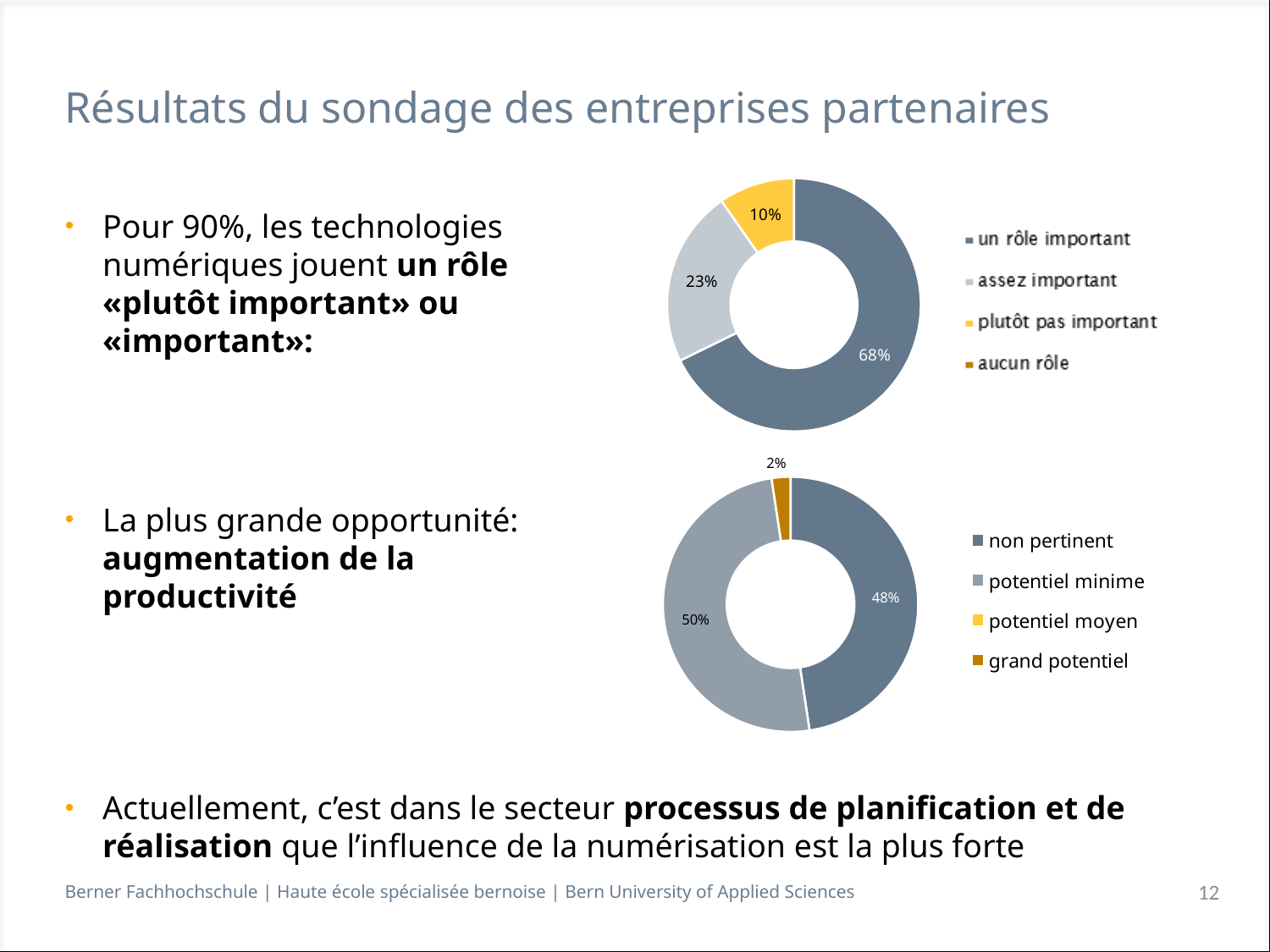
In the top doughnut chart, which category has the largest share? un rôle important How many entries does the legend of the bottom doughnut chart list? 4 What type of chart is the top chart on the slide? Doughnut chart In the bottom doughnut chart, what percentage is shown for "potentiel minime"? 50% In the top doughnut chart, what percentage is shown for "plutôt pas important"? 10% In the bottom doughnut chart, what percentage is shown for "non pertinent"? 48% In the bottom doughnut chart, what percentage is shown for "grand potentiel"? 2% In the top doughnut chart, what is the difference between the shares for "un rôle important" and "assez important"? 45% In the bottom doughnut chart, which has the larger share: "potentiel minime" or "grand potentiel"? potentiel minime How many entries does the legend of the top doughnut chart list? 4 In the top doughnut chart, what percentage is shown for "assez important"? 23% In the top doughnut chart, what percentage is shown for "un rôle important"? 68%